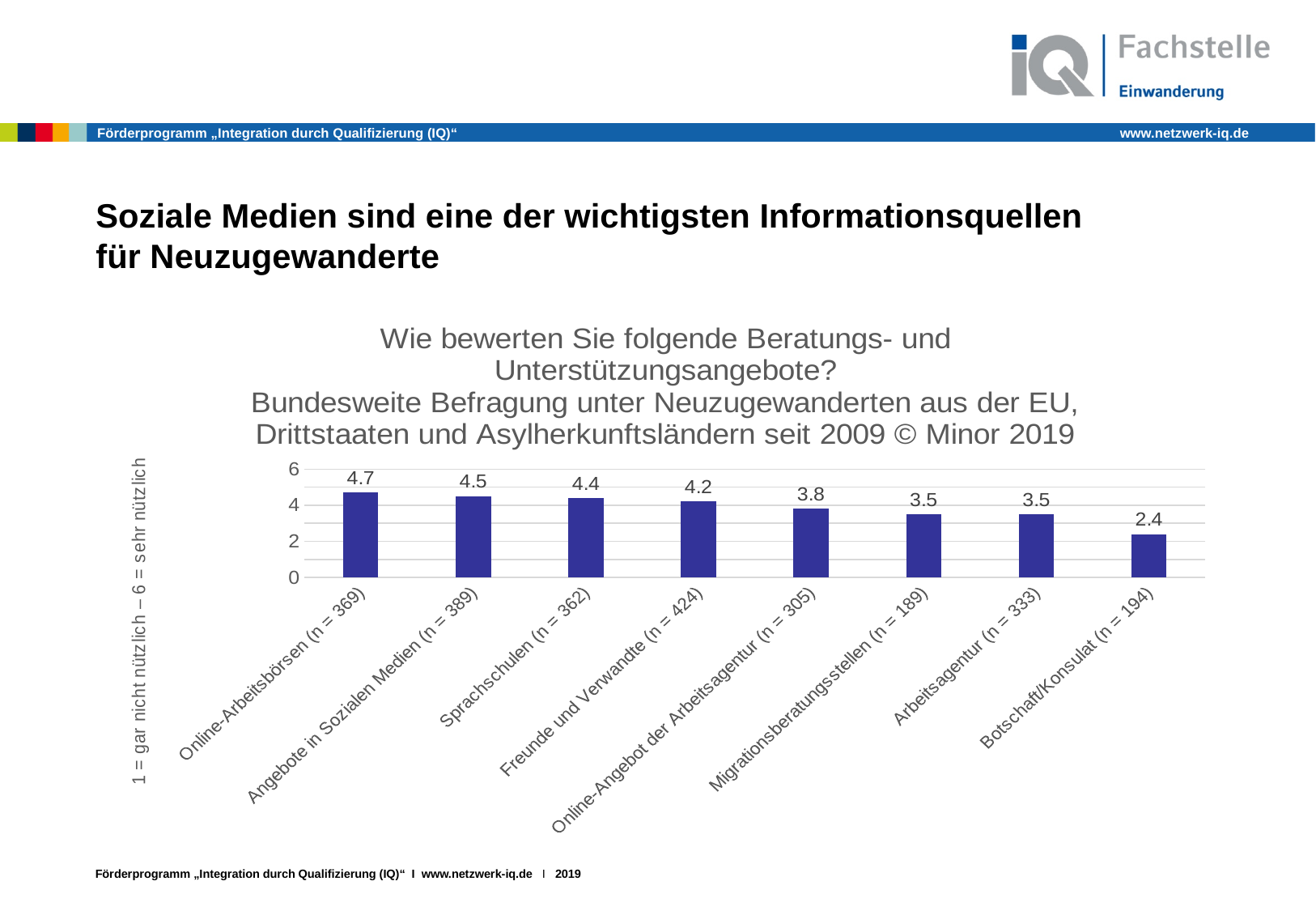
What is the value for Online-Arbeitsbörsen (n = 369)? 4.7 What kind of chart is shown on the slide? bar chart Which category has the highest value? Online-Arbeitsbörsen (n = 369) What does the y-axis label say the scale ranges from? 1 = gar nicht nützlich – 6 = sehr nützlich What is the value for Botschaft/Konsulat (n = 194)? 2.4 Do the values rise or fall from left to right along the x axis? fall How many categories are shown in the chart? 8 What is the difference between the values for Online-Arbeitsbörsen (n = 369) and Botschaft/Konsulat (n = 194)? 2.3 Is the value for Online-Angebot der Arbeitsagentur (n = 305) greater or less than 4? less What is the value for Angebote in Sozialen Medien (n = 389)? 4.5 Which has a higher value, Sprachschulen (n = 362) or Freunde und Verwandte (n = 424)? Sprachschulen (n = 362) Which category has the lowest value? Botschaft/Konsulat (n = 194)